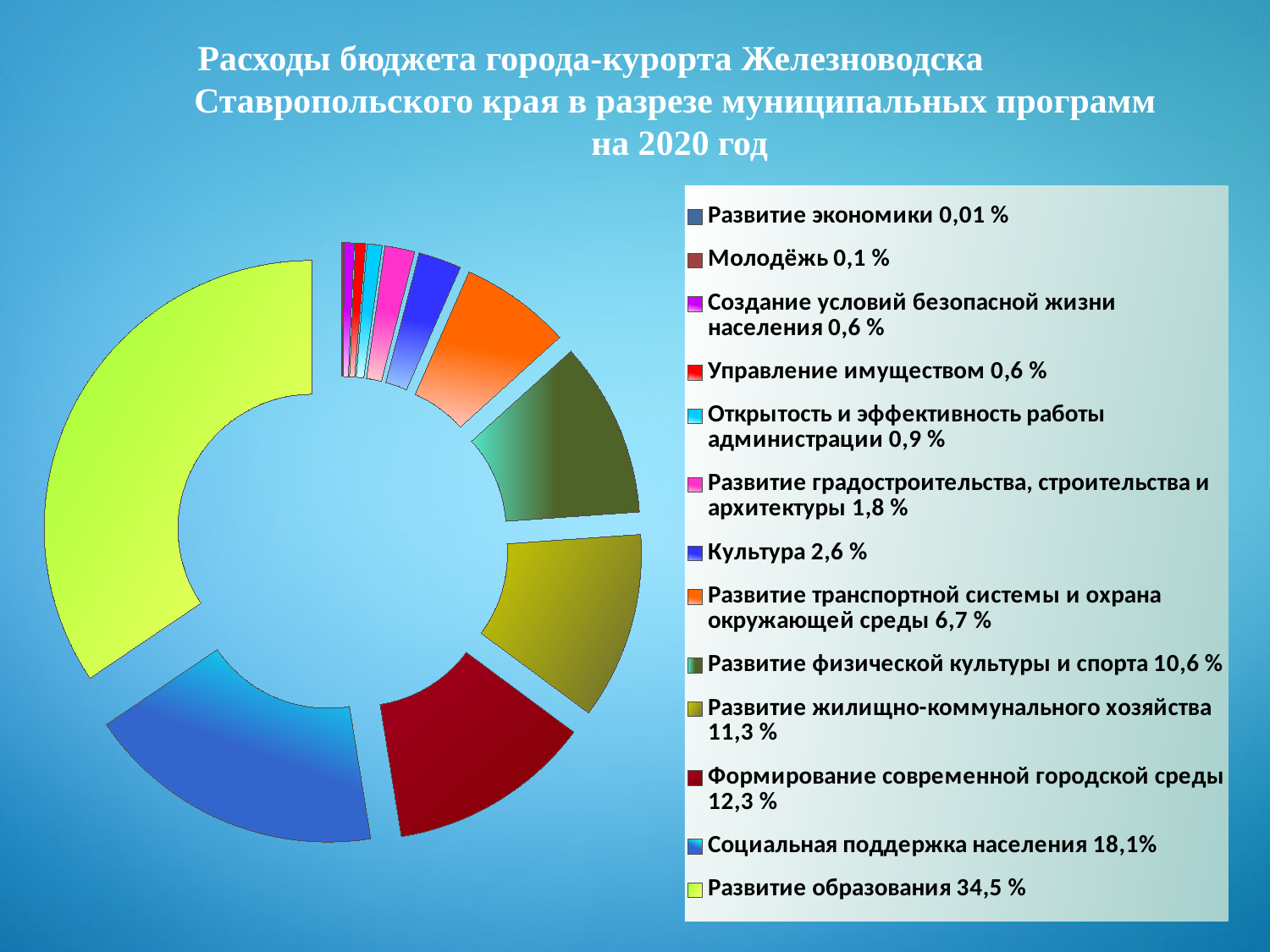
What is the difference between the shares of Развитие образования and Социальная поддержка населения? 16,4 % What year does the chart title refer to? 2020 Which program has the smallest share of the budget? Развитие экономики What is the value for Развитие транспортной системы и охрана окружающей среды? 6,7 % What is the difference between Формирование современной городской среды and Развитие жилищно-коммунального хозяйства? 1,0 % What share of the budget goes to Развитие образования? 34,5 % How many programs (categories) are shown in the chart? 13 What percentage is listed for Культура? 2,6 % What is the value shown for Социальная поддержка населения? 18,1% What kind of chart is shown on the slide? Doughnut (pie) chart Which is larger: Развитие физической культуры и спорта or Развитие жилищно-коммунального хозяйства? Развитие жилищно-коммунального хозяйства Which program has the largest share of the budget? Развитие образования